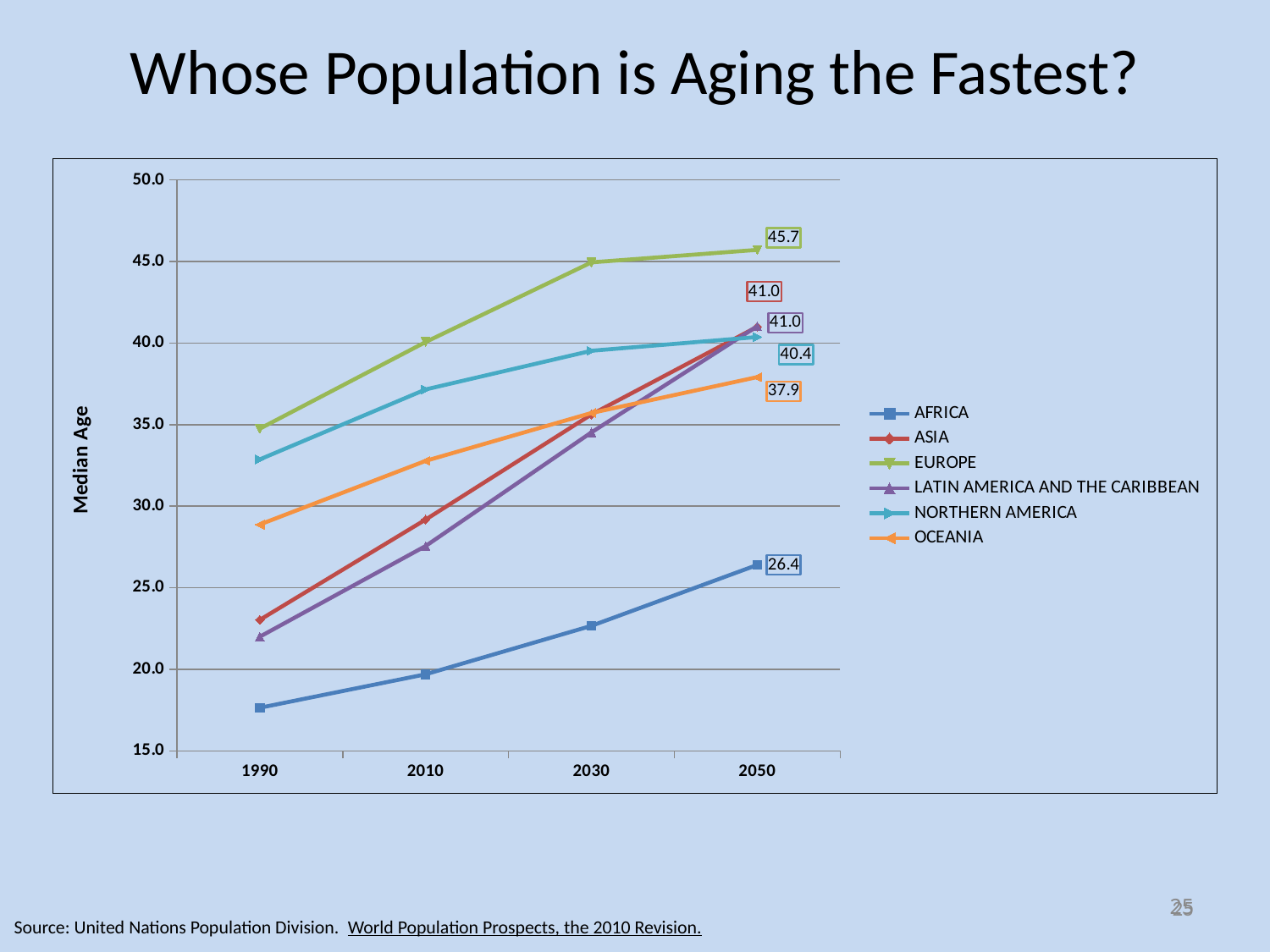
What is the median age for Europe in 2050? 45.7 How many series does the legend list? 6 In 2050, which has the larger median age, Northern America or Oceania? Northern America What is the median age for Oceania in 2050? 37.9 What is the median age for Africa in 2050? 26.4 Which region has the lowest median age in 2050? Africa What is the median age for Northern America in 2050? 40.4 What is the difference between the 2050 median age of Europe and that of Africa? 19.3 What kind of chart is shown on the slide? line chart How many years are shown on the x axis? 4 Which region has the highest median age in 2050? Europe Is the median age for Africa in 1990 greater or less than 20.0? less